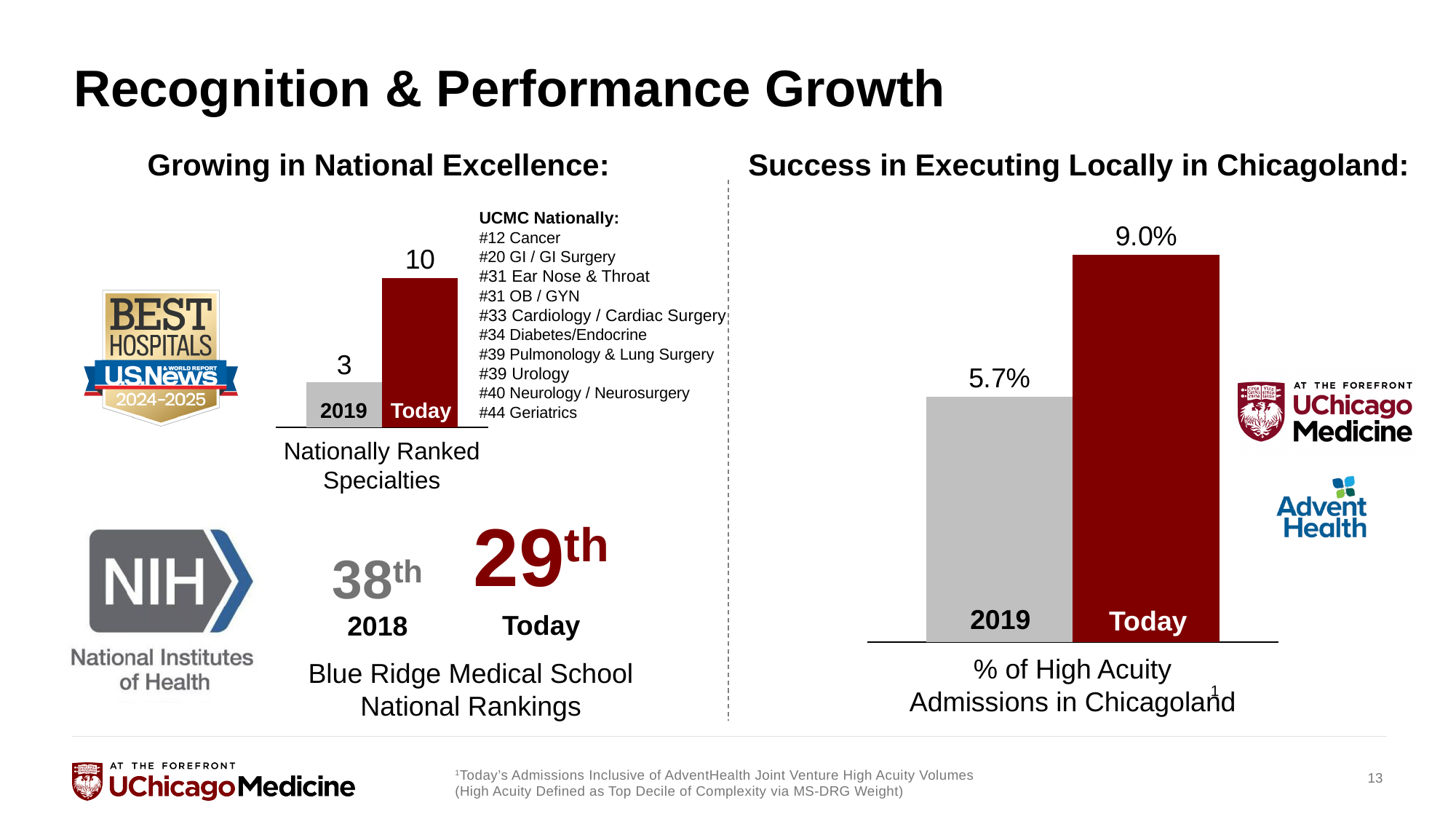
How many bars are in the Nationally Ranked Specialties chart? 2 In the % of High Acuity Admissions in Chicagoland chart, what is the value for Today? 9.0% What kind of chart is the Nationally Ranked Specialties chart? Bar chart In the % of High Acuity Admissions in Chicagoland chart, which bar is the highest? Today In the % of High Acuity Admissions in Chicagoland chart, do the values rise or fall from 2019 to Today? Rise In the % of High Acuity Admissions in Chicagoland chart, what is the value for 2019? 5.7% In the Nationally Ranked Specialties chart, by how much did the number of nationally ranked specialties increase from 2019 to Today? 7 In the % of High Acuity Admissions in Chicagoland chart, what is the difference between Today and 2019? 3.3% In the % of High Acuity Admissions in Chicagoland chart, what colour is the Today bar? Dark red In the Nationally Ranked Specialties chart, which bar is higher, 2019 or Today? Today In the Nationally Ranked Specialties chart, what is the value for Today? 10 In the Nationally Ranked Specialties chart, what is the value for 2019? 3